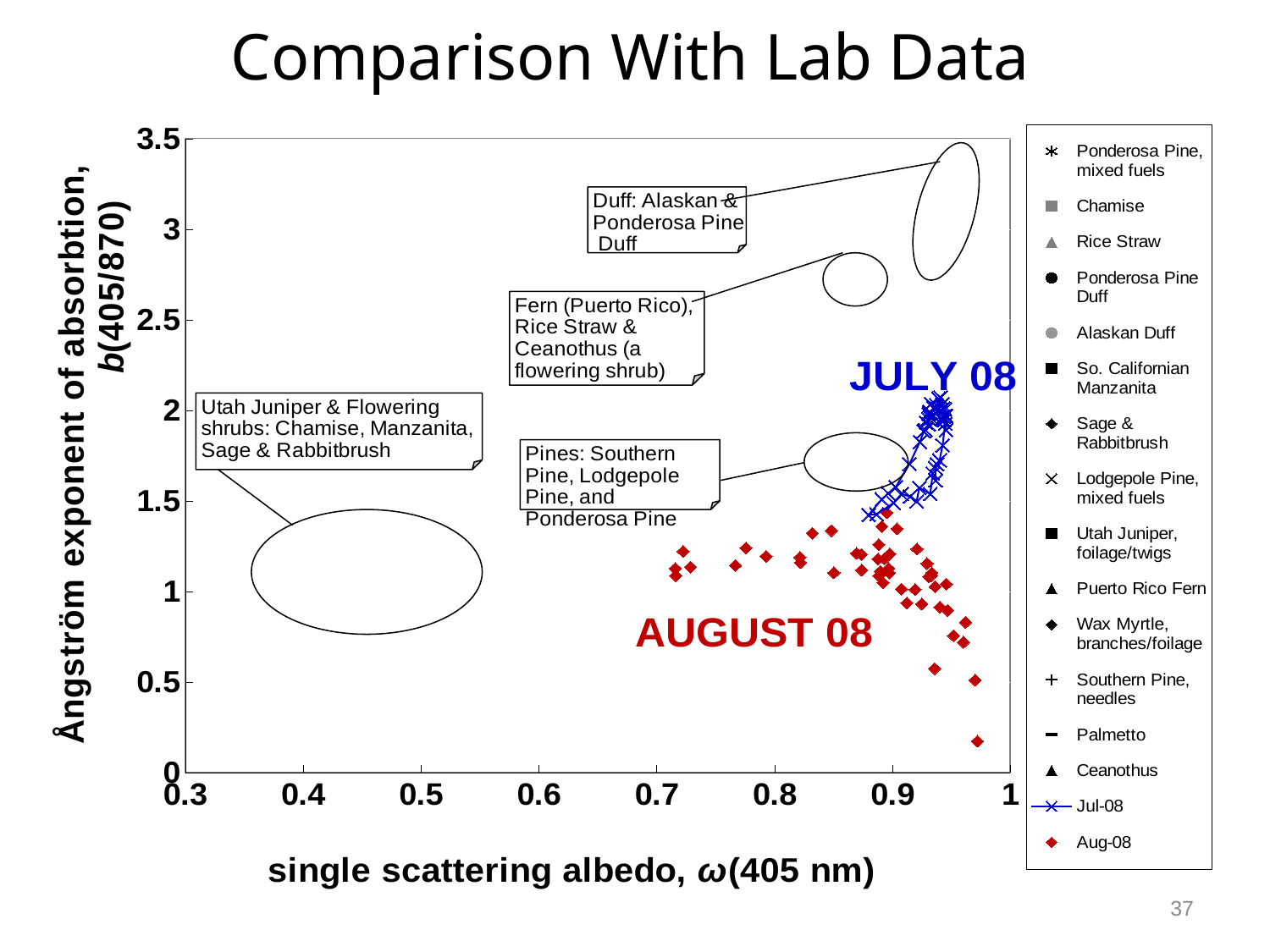
How many entries does the legend list? 16 Is the single scattering albedo of the Aug-08 points greater or less than 0.6? greater Is the single scattering albedo of the Jul-08 points greater or less than 0.8? greater What is the title of the chart? Comparison With Lab Data What colour are the Aug-08 markers? red Are the Ångström exponent values of the Jul-08 points greater or less than 1? greater Do the Aug-08 Ångström exponent values generally rise or fall as single scattering albedo increases? fall Which series has higher Ångström exponent values overall, Jul-08 or Aug-08? Jul-08 What kind of chart is shown on the slide? scatter chart